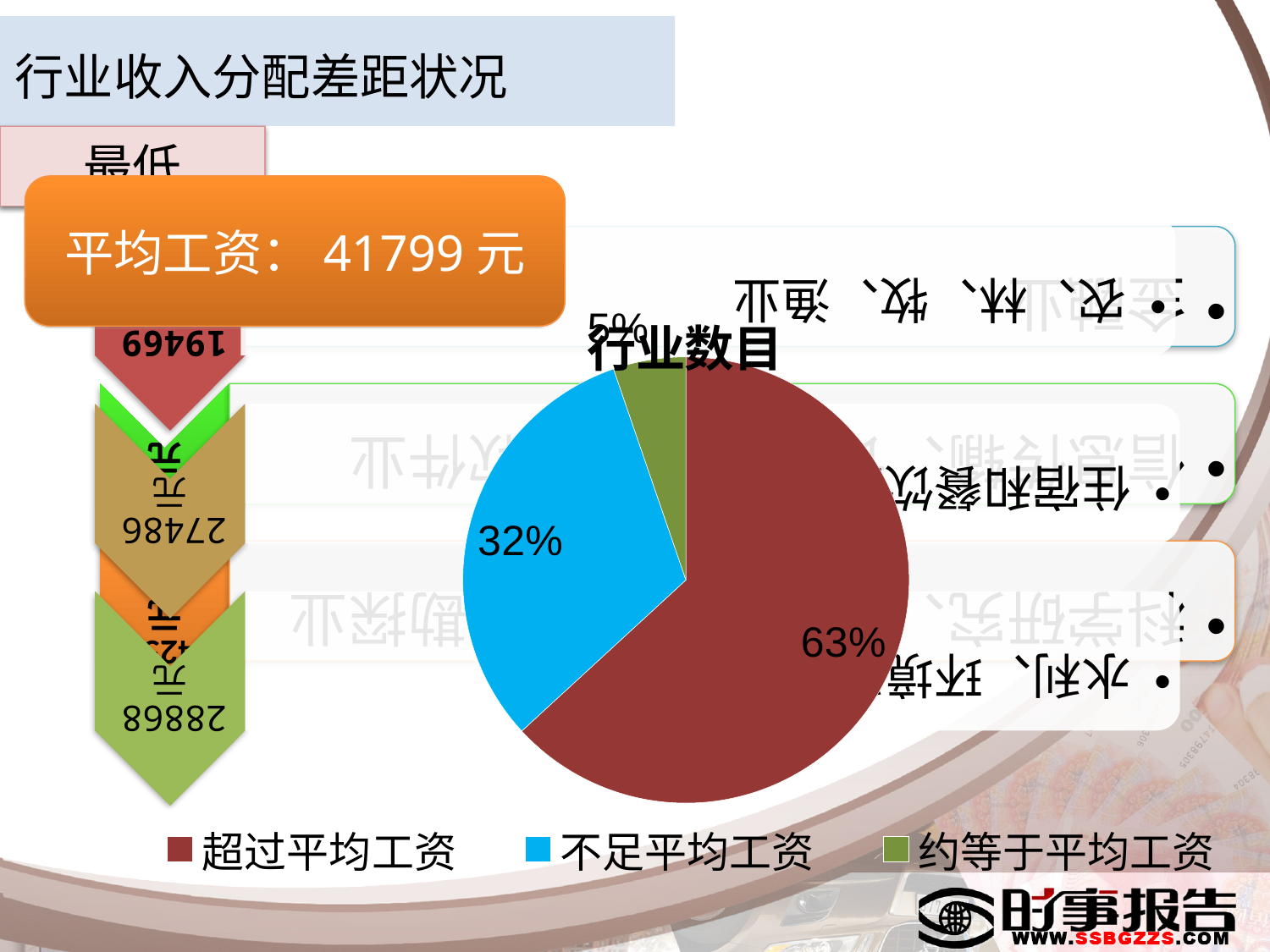
What share of the pie does 超过平均工资 take? 63% What is the title of the pie chart? 行业数目 What share of the pie does 不足平均工资 take? 32% What kind of chart is shown on the slide? pie chart Which category has the largest slice of the pie? 超过平均工资 What share of the pie does 约等于平均工资 take? 5% How many slices does the pie chart have? 3 How many entries does the legend list? 3 Which colour represents 不足平均工资 in the pie chart? blue Which is larger, the share for 不足平均工资 or the share for 约等于平均工资? 不足平均工资 Which category has the smallest slice of the pie? 约等于平均工资 What is the difference in percentage points between 超过平均工资 and 不足平均工资? 31